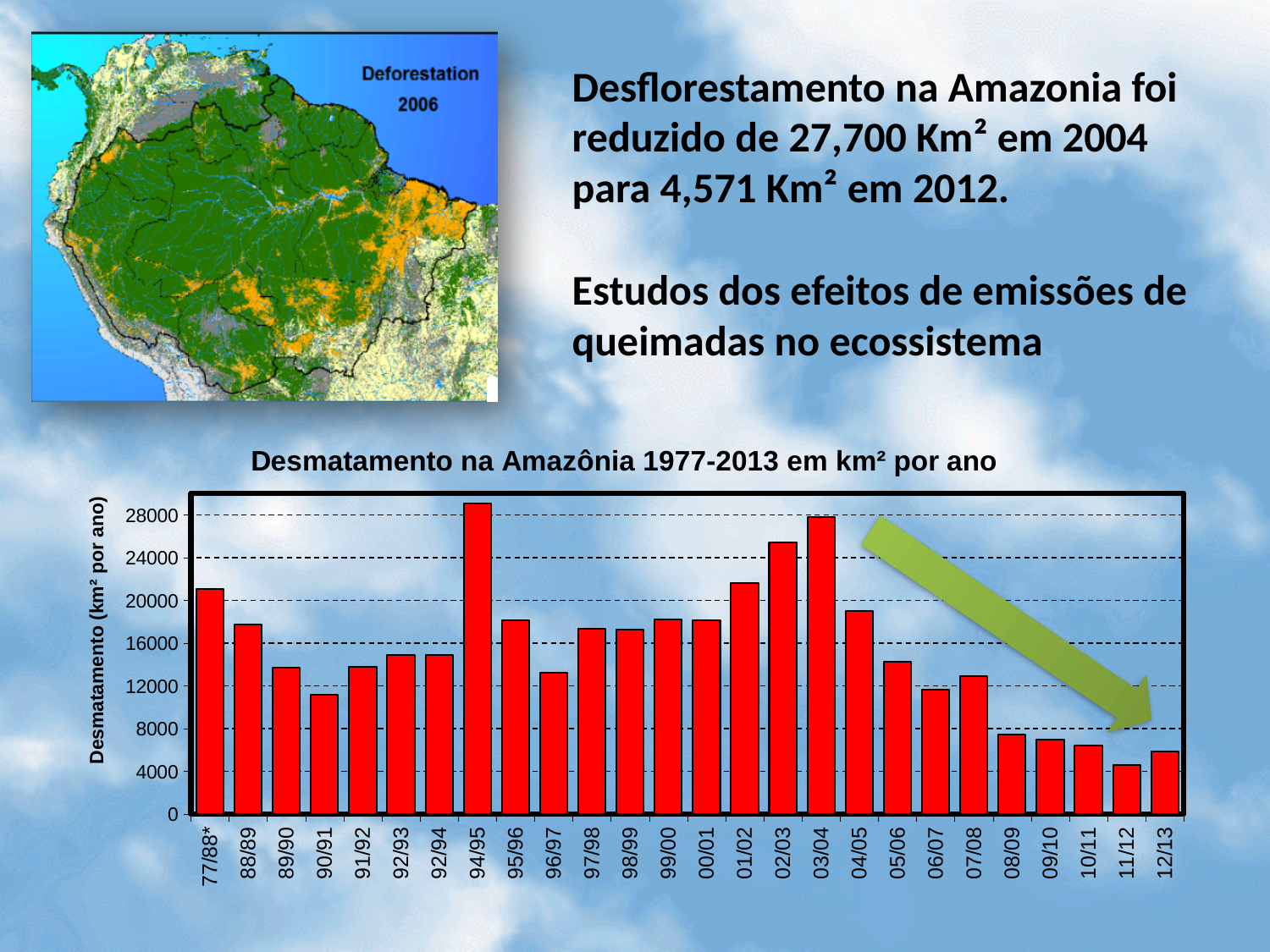
What kind of chart is shown on the slide? bar chart What is the title of the chart? Desmatamento na Amazônia 1977-2013 em km² por ano Is the value for 03/04 greater or less than 24000? greater Do the values generally rise or fall from 04/05 to 12/13? fall Which year category has the highest deforestation value? 94/95 Is the value for 11/12 greater or less than 8000? less Which year category has the lowest deforestation value? 11/12 What is the label of the vertical axis of the chart? Desmatamento (km² por ano) Which has the larger value, 02/03 or 03/04? 03/04 Is the value for 94/95 greater or less than 28000? greater How many year categories are shown on the x axis of the chart? 26